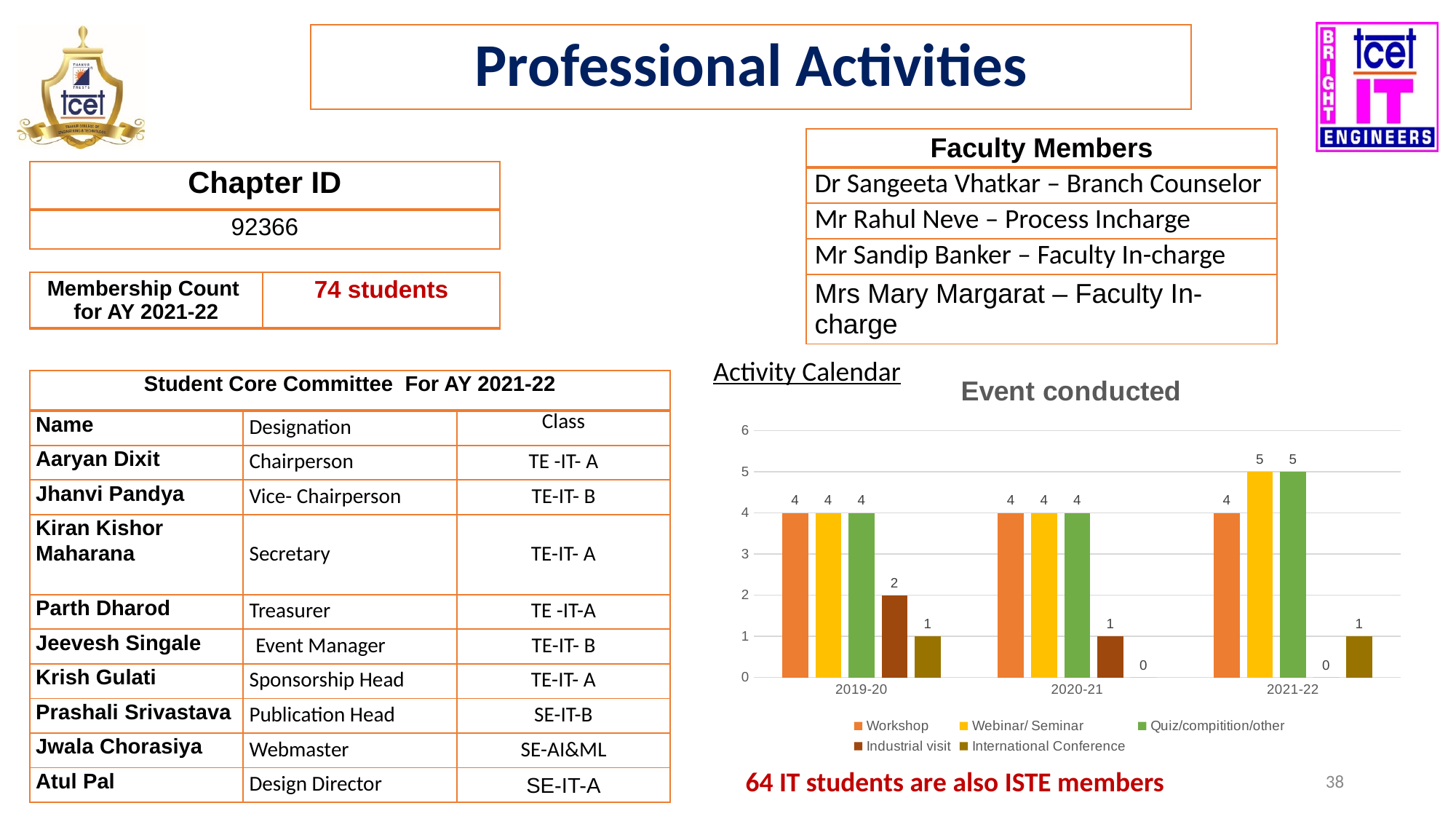
In the 'Event conducted' chart, which series has the lowest value in 2021-22? Industrial visit What is the title of the chart on the slide? Event conducted How many academic years are shown on the x axis of the 'Event conducted' chart? 3 In the 'Event conducted' chart, what is the value for Industrial visit in 2019-20? 2 In the 'Event conducted' chart, what is the value for International Conference in 2020-21? 0 In the 'Event conducted' chart, is the Webinar/ Seminar value larger in 2020-21 or in 2021-22? 2021-22 In the 'Event conducted' chart, how does the Quiz/compitition/other value change from 2020-21 to 2021-22? rises In the 'Event conducted' chart, what is the value for Webinar/ Seminar in 2021-22? 5 In the 'Event conducted' chart, what is the value for Workshop in 2020-21? 4 In the 'Event conducted' chart, what is the difference between the Workshop value and the Industrial visit value in 2019-20? 2 How many series does the legend of the 'Event conducted' chart list? 5 What kind of chart is the 'Event conducted' chart? bar chart